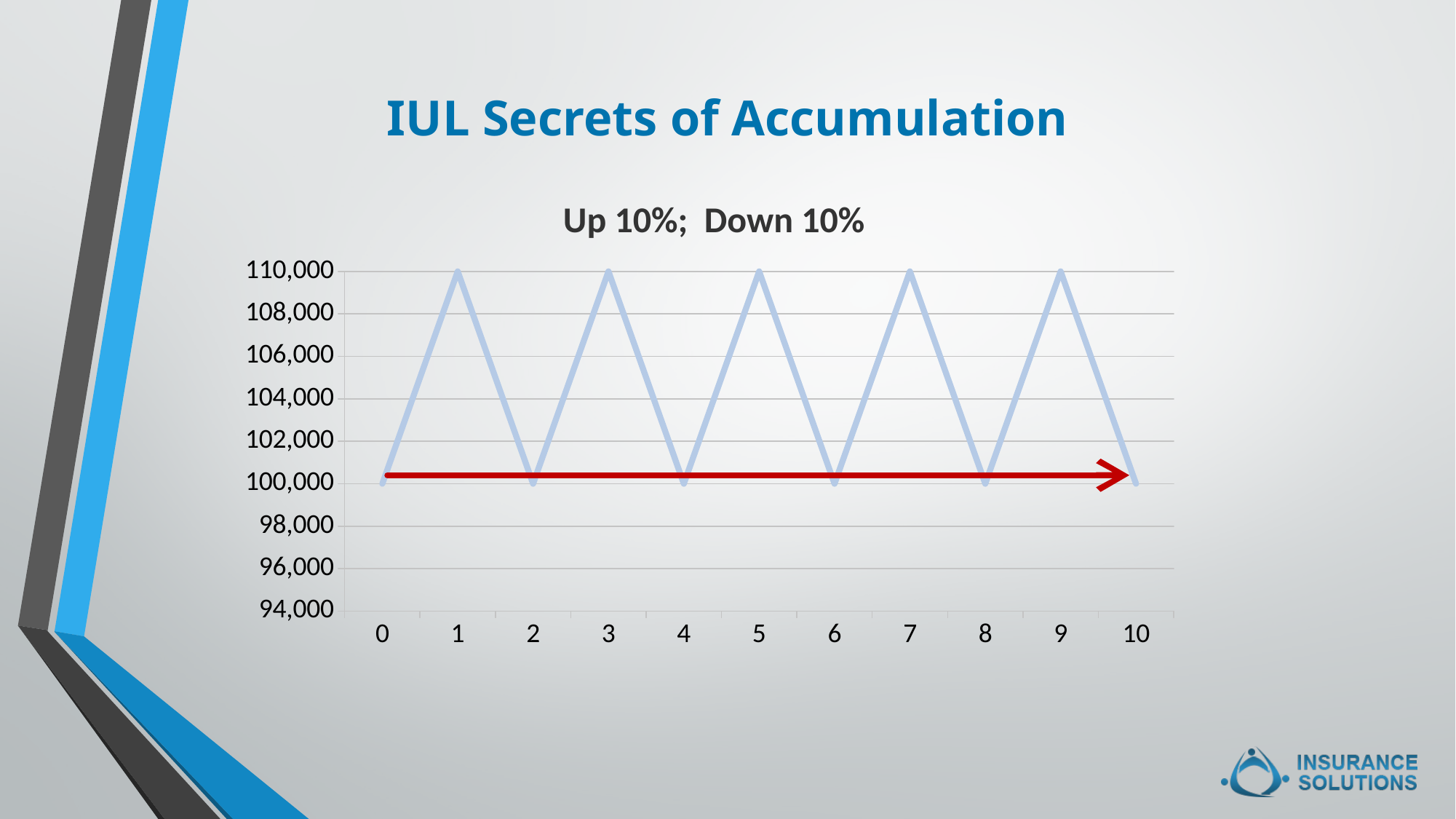
How many points are plotted on the line (x values 0 through 10)? 11 Is the value at x = 5 greater or less than 104,000? greater Is the value at x = 6 greater or less than 104,000? less What is the title of the chart? Up 10%; Down 10% What kind of chart is shown on the slide? line chart What is the value at x = 2? 100,000 What is the value at x = 10? 100,000 Which is larger, the value at x = 3 or the value at x = 4? x = 3 What is the value at x = 9? 110,000 What is the value at x = 1? 110,000 Comparing the value at x = 0 with the value at x = 10, does the line end higher, lower, or at the same level? same level What is the difference between the value at x = 1 and the value at x = 0? 10,000